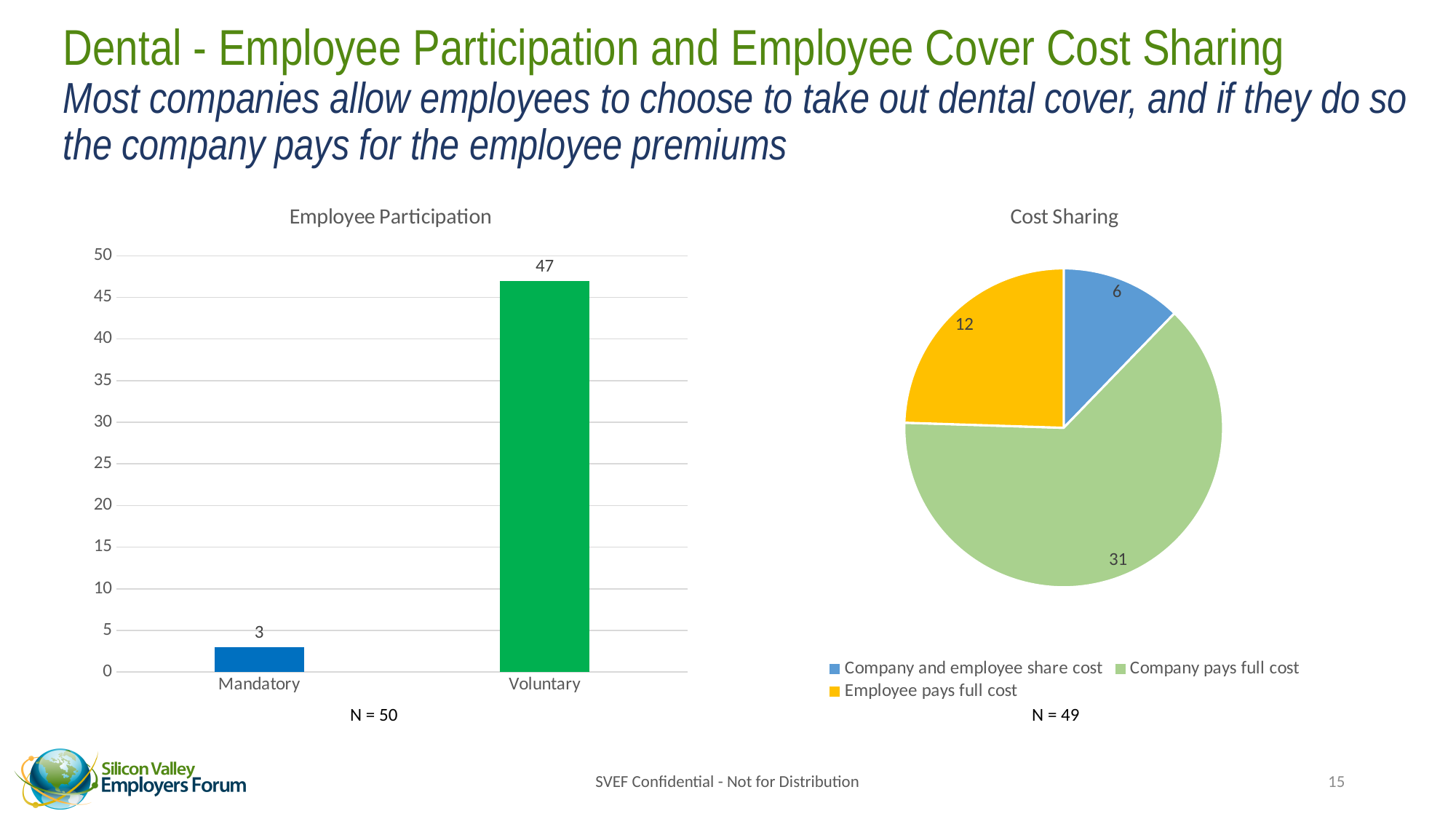
In the Cost Sharing chart, what is the value for Company pays full cost? 31 In the Cost Sharing chart, which is larger: Employee pays full cost or Company and employee share cost? Employee pays full cost In the Employee Participation chart, what is the value for Mandatory? 3 In the Employee Participation chart, what is the difference between the Voluntary and Mandatory values? 44 What kind of chart is the Cost Sharing chart? Pie chart What kind of chart is the Employee Participation chart? Bar chart In the Employee Participation chart, which category has the highest value? Voluntary In the Employee Participation chart, what is the value for Voluntary? 47 In the Cost Sharing chart, how many entries does the legend list? 3 In the Cost Sharing chart, what is the value for Employee pays full cost? 12 In the Cost Sharing chart, which category has the smallest slice? Company and employee share cost In the Employee Participation chart, how many categories are shown? 2